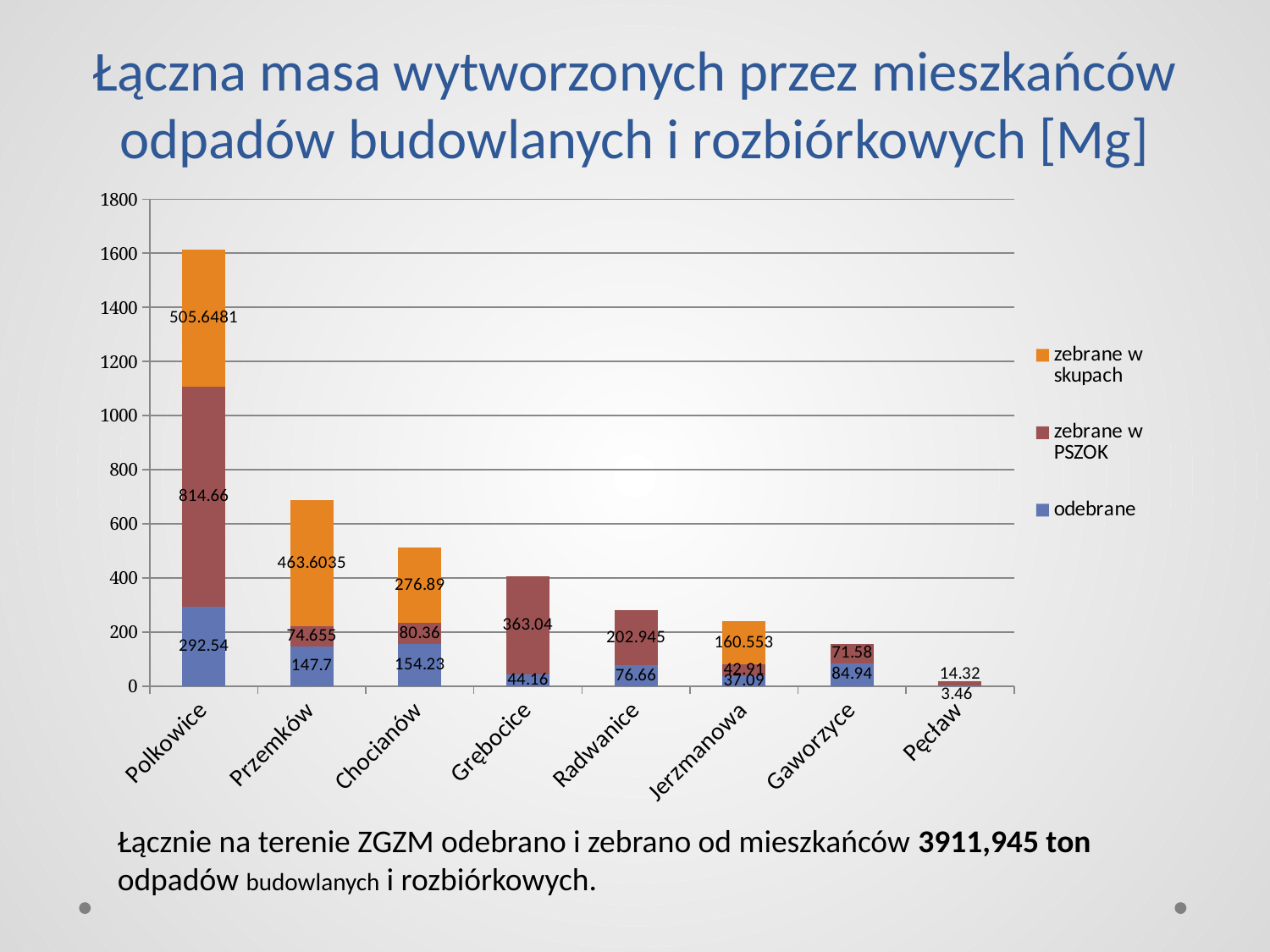
How many municipalities are shown on the x axis? 8 Which has the larger "odebrane" value, Chocianów or Przemków? Chocianów What is the value of the "zebrane w PSZOK" series for Grębocice? 363.04 What is the value of the "odebrane" series for Polkowice? 292.54 What is the total of the stacked bar for Pęcław? 17.78 Is the total stacked value for Polkowice greater or less than 1400? greater For Polkowice, what is the difference between the "zebrane w PSZOK" value and the "odebrane" value? 522.12 What is the value of the "zebrane w skupach" series for Przemków? 463.6035 What kind of chart is shown on the slide? stacked bar chart How many series does the legend list? 3 Which municipality has the highest total stacked bar? Polkowice Which municipality has the lowest total stacked bar? Pęcław